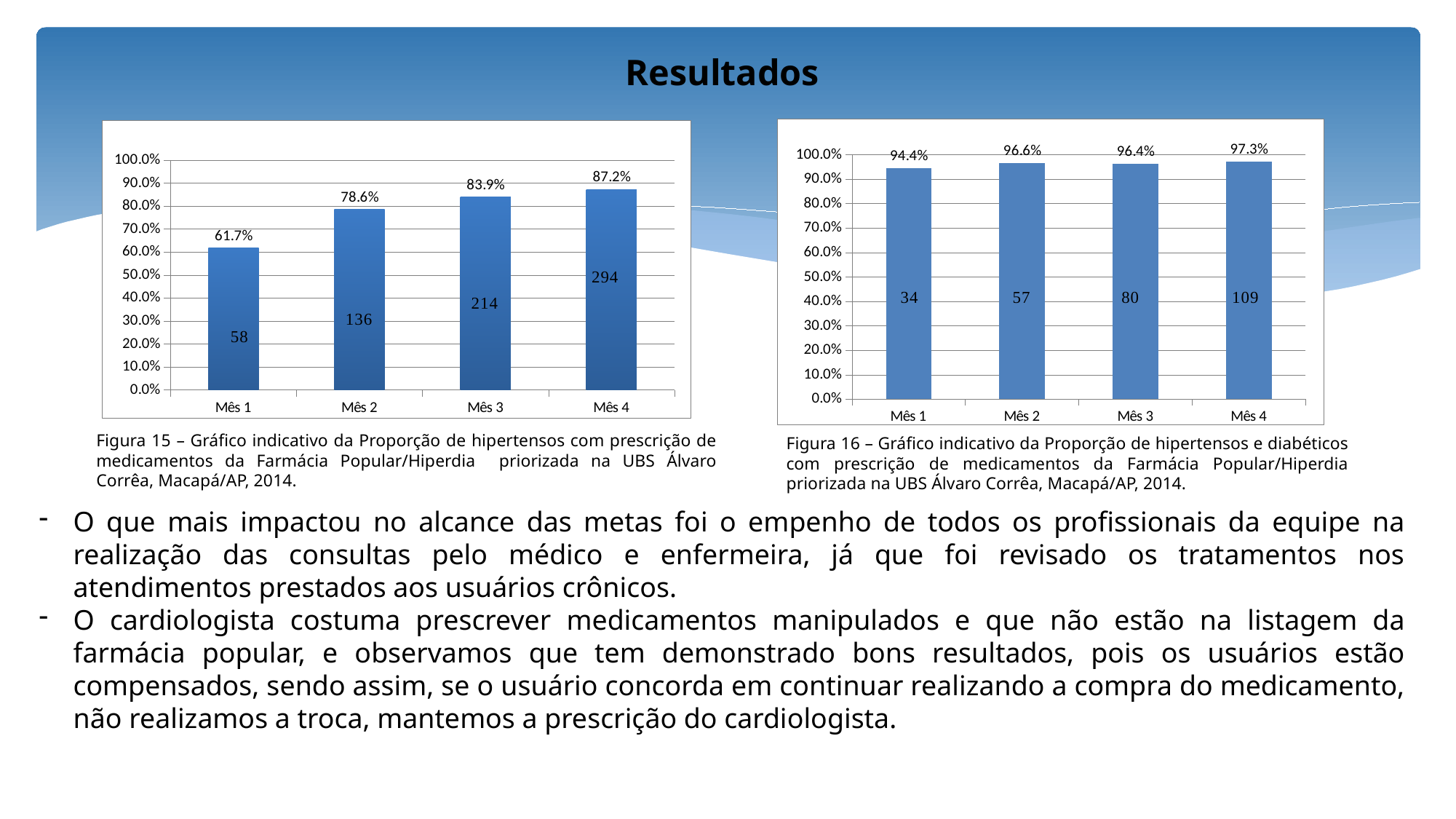
In the left chart (Figura 15), is the value for Mês 1 greater or less than 70.0%? less How many months (categories) are shown in the right chart (Figura 16)? 4 In the right chart (Figura 16), what is the percentage value for Mês 4? 97.3% What type of chart is the left chart (Figura 15)? Bar chart In the left chart (Figura 15), what is the difference in percentage points between Mês 4 and Mês 1? 25.5 In the left chart (Figura 15), which month has the highest percentage? Mês 4 In the left chart (Figura 15), do the percentage values rise or fall from Mês 1 to Mês 4? Rise In the right chart (Figura 16), which month has the lowest percentage? Mês 1 In the right chart (Figura 16), what number is printed inside the bar for Mês 2? 57 In the left chart (Figura 15), what is the percentage value for Mês 2? 78.6% In the left chart (Figura 15), what number is printed inside the bar for Mês 3? 214 In the right chart (Figura 16), which is larger, the percentage for Mês 2 or Mês 3? Mês 2